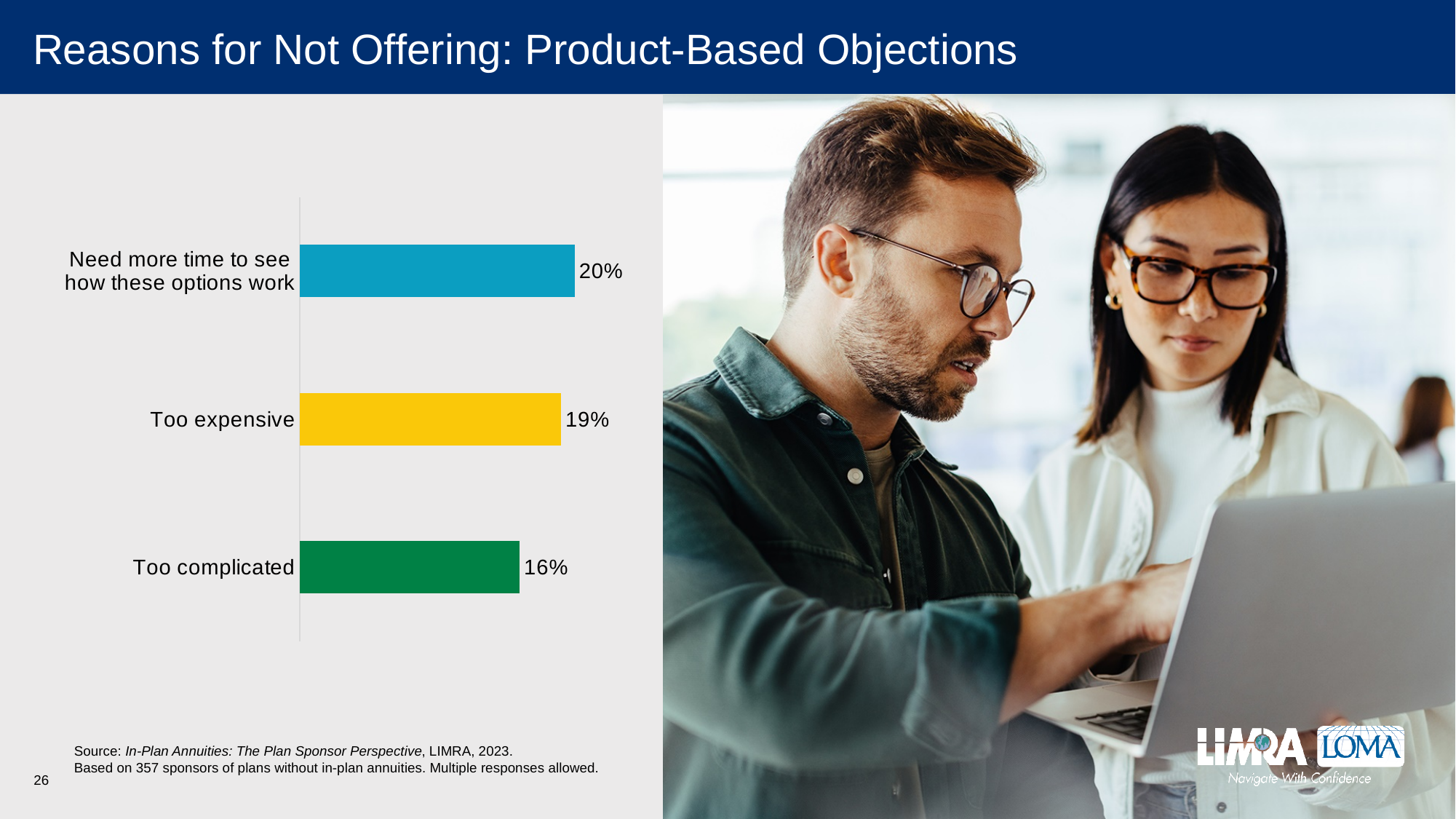
What is the difference in percentage points between 'Too expensive' and 'Too complicated'? 3 percentage points How many sponsors is the chart based on, according to the source note? 357 How many reasons are shown in the chart? 3 What kind of chart is shown on the slide? Bar chart What percentage of sponsors cited 'Need more time to see how these options work' as a reason for not offering? 20% What colour is the bar for 'Too expensive'? Yellow Which has a higher percentage: 'Too expensive' or 'Too complicated'? Too expensive What is the difference in percentage points between 'Need more time to see how these options work' and 'Too complicated'? 4 percentage points Which reason has the lowest percentage? Too complicated Which reason has the highest percentage? Need more time to see how these options work What percentage of sponsors cited 'Too complicated' as a reason for not offering? 16% What percentage of sponsors cited 'Too expensive' as a reason for not offering? 19%